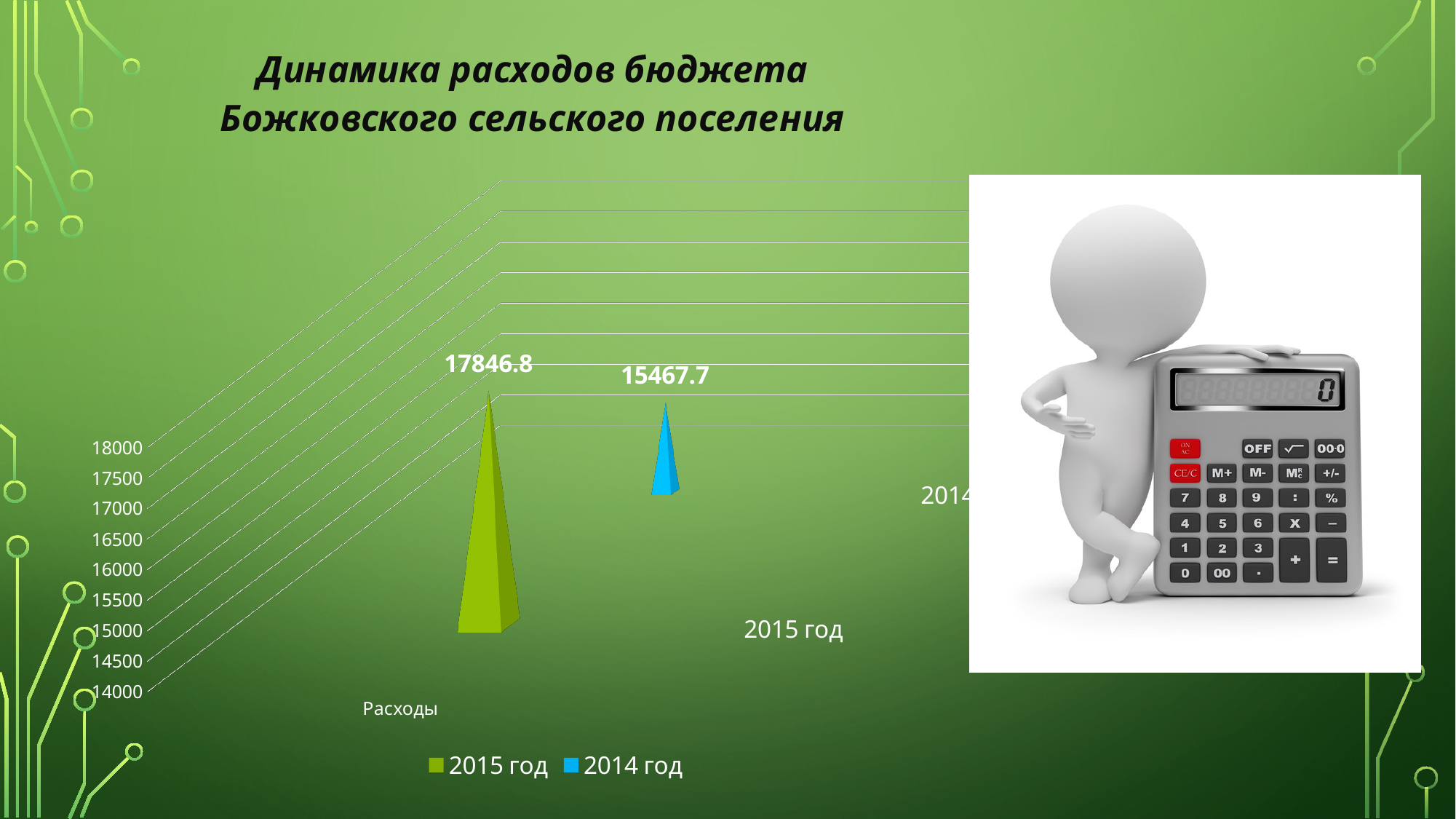
What is the value for 2015 год in the chart? 17846.8 Which colour represents 2014 год in the legend? blue What is the value for 2014 год in the chart? 15467.7 What kind of chart is shown on the slide? bar chart Is the value for 2015 год greater or less than 17500? greater What is the category label shown on the x axis of the chart? Расходы What is the difference between the 2015 год and 2014 год values? 2379.1 Which series has the higher value, 2015 год or 2014 год? 2015 год Which year shows the highest expenditure value? 2015 год Which year shows the lowest expenditure value? 2014 год How many series does the legend list? 2 Is the value for 2014 год greater or less than 16000? less